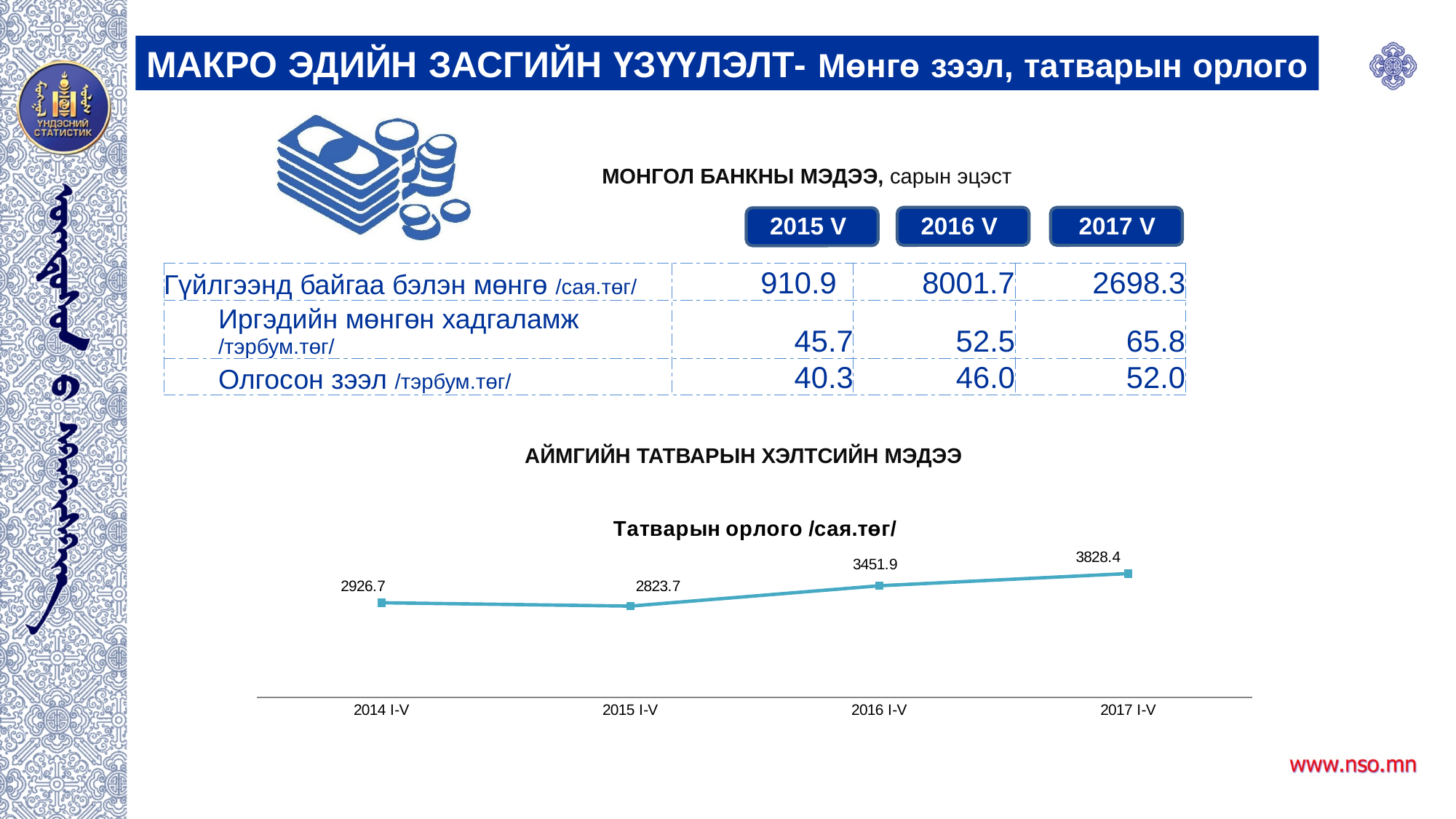
What is the difference between the 2017 I-V and 2016 I-V values in the Татварын орлого /сая.төг/ chart? 376.5 What kind of chart is the Татварын орлого /сая.төг/ chart? Line chart What is the value for 2015 I-V in the Татварын орлого /сая.төг/ chart? 2823.7 Which period has the highest value in the Татварын орлого /сая.төг/ chart? 2017 I-V What is the difference between the 2014 I-V and 2015 I-V values in the Татварын орлого /сая.төг/ chart? 103.0 In the Татварын орлого /сая.төг/ chart, do the values rise or fall from 2015 I-V to 2017 I-V? Rise What is the value for 2017 I-V in the Татварын орлого /сая.төг/ chart? 3828.4 What is the value for 2014 I-V in the Татварын орлого /сая.төг/ chart? 2926.7 What is the value for 2016 I-V in the Татварын орлого /сая.төг/ chart? 3451.9 In the Татварын орлого /сая.төг/ chart, which is larger: the value for 2016 I-V or the value for 2014 I-V? 2016 I-V How many data points are plotted in the Татварын орлого /сая.төг/ chart? 4 Which period has the lowest value in the Татварын орлого /сая.төг/ chart? 2015 I-V